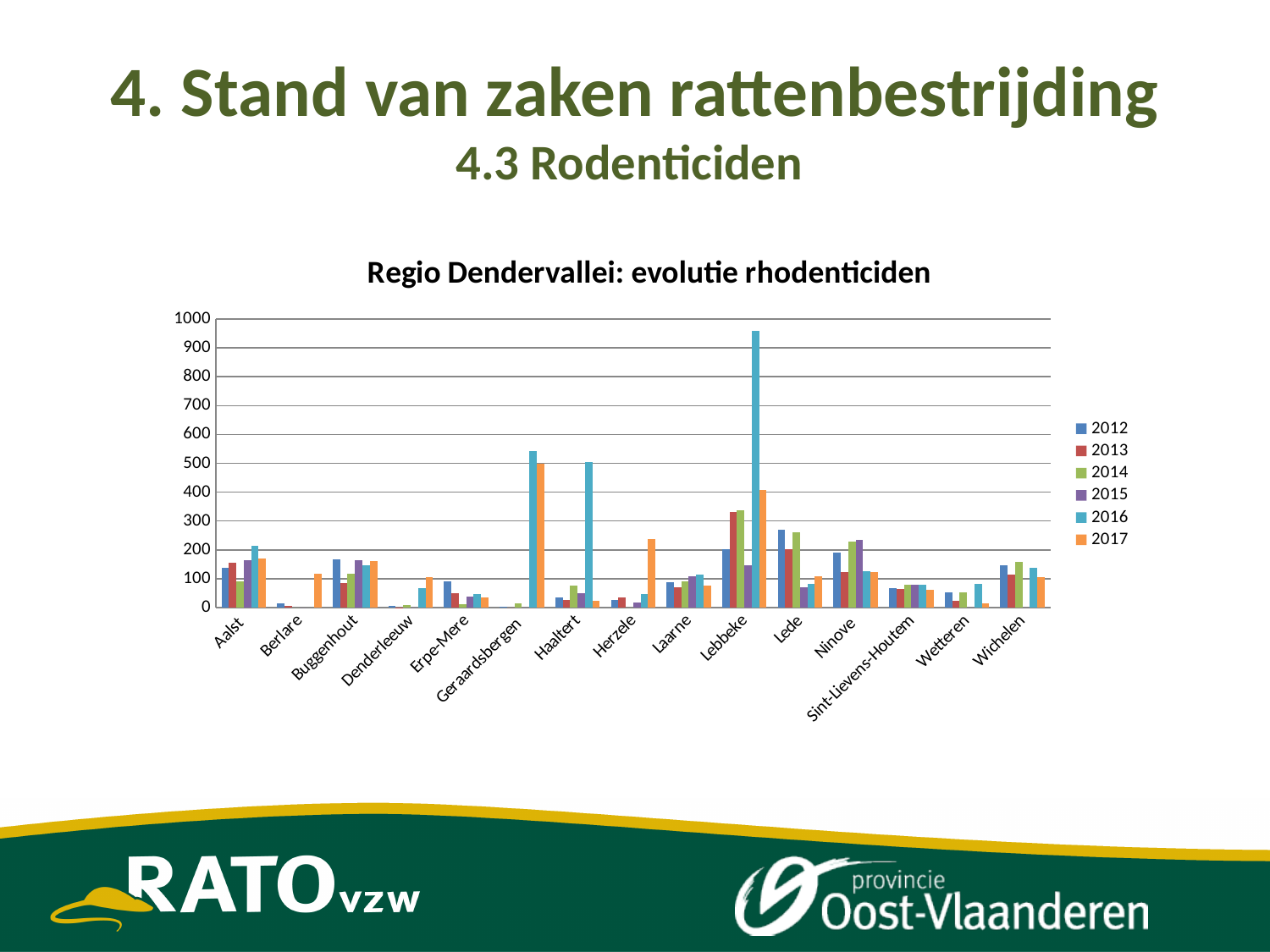
What is the title of the chart? Regio Dendervallei: evolutie rhodenticiden How many series does the legend list? 6 Is the 2017 value for Herzele greater or less than 200? greater Which is larger for Ninove: the 2013 value or the 2014 value? 2014 What kind of chart is shown on the slide? bar chart Which municipality has the highest 2017 bar? Geraardsbergen How many municipalities (categories) are shown on the x axis? 15 Which municipality has the highest 2016 bar? Lebbeke Which is larger for Lede: the 2012 value or the 2013 value? 2012 Is the 2012 value for Lede greater or less than 300? less Is the 2016 value for Lebbeke greater or less than 900? greater